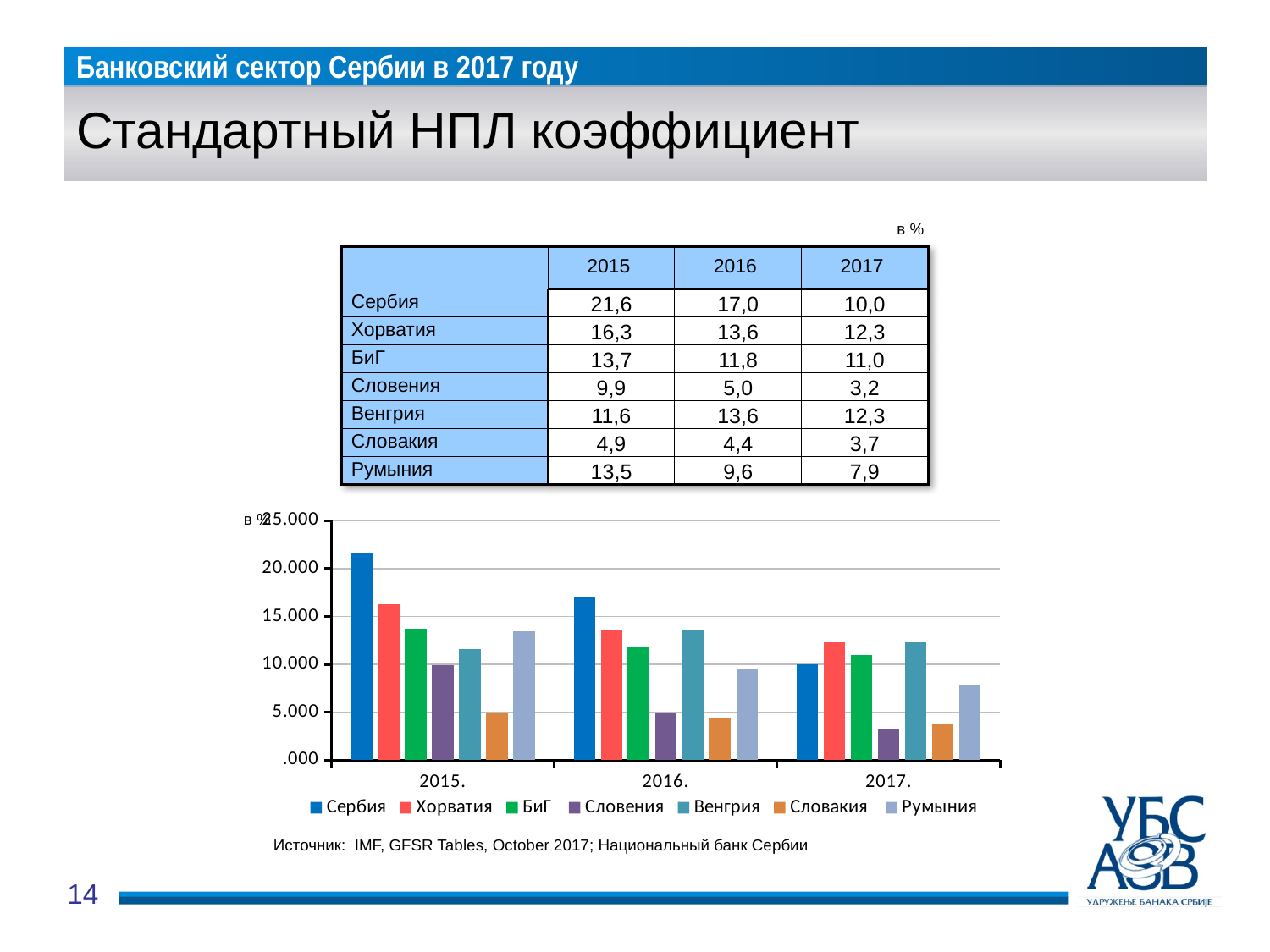
How many series does the chart legend list? 7 What is the value for Сербия in 2015? 21,6 Which country has the lowest value in 2016? Словакия Does the value for Сербия rise or fall from 2015 to 2017? fall How many year groups are shown on the x axis of the chart? 3 Is the value for Сербия in 2016 greater or less than 15.000? greater Which is larger in 2017, the value for Хорватия or the value for БиГ? Хорватия What kind of chart is shown on the slide? bar chart What is the value for Словения in 2017? 3,2 Which country has the highest value in 2015? Сербия What is the difference between the values for Сербия in 2015 and 2017? 11,6 What is the value for Румыния in 2016? 9,6